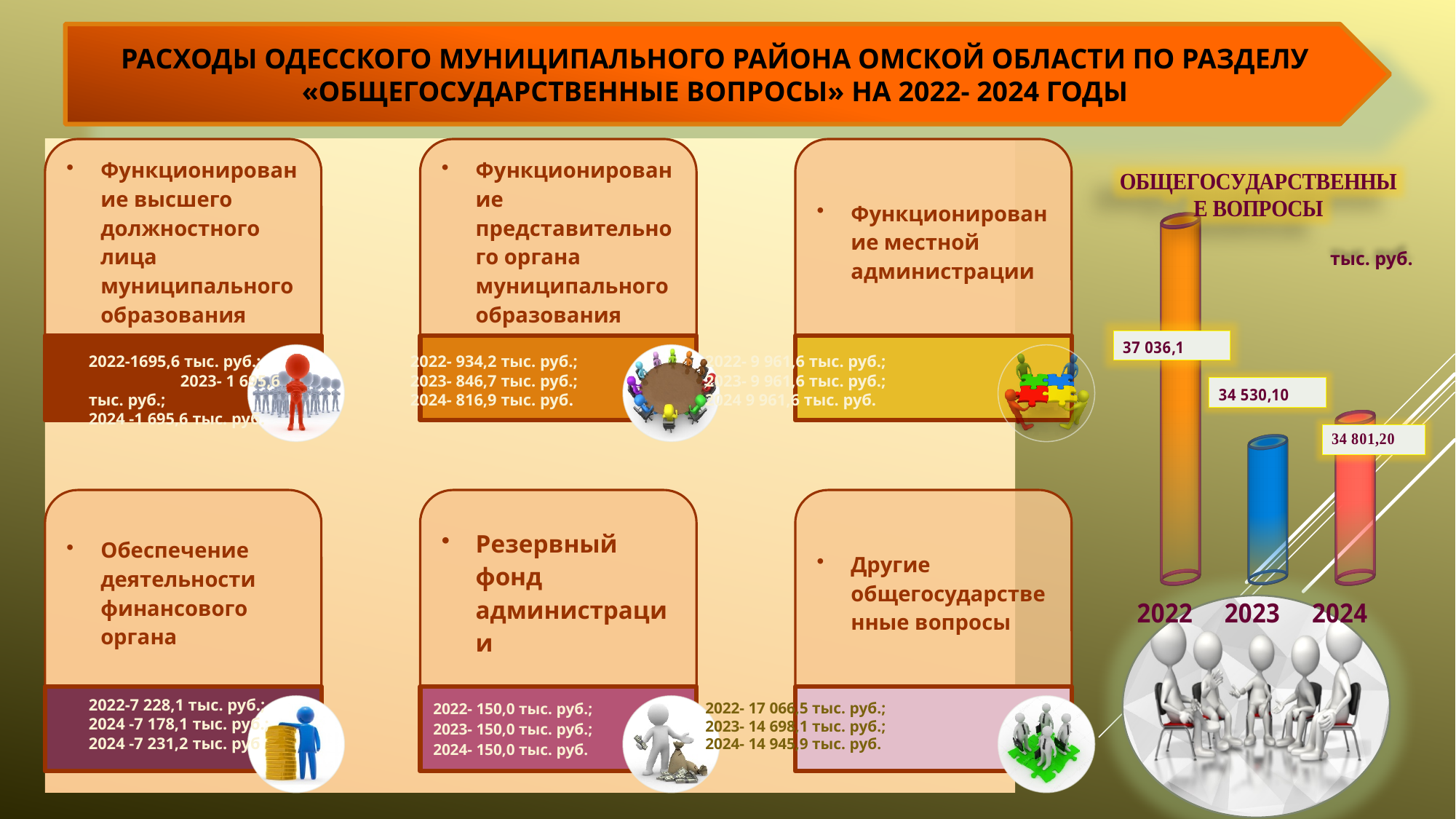
In the chart «ОБЩЕГОСУДАРСТВЕННЫЕ ВОПРОСЫ», which year has the lowest value? 2023 In the chart «ОБЩЕГОСУДАРСТВЕННЫЕ ВОПРОСЫ», how do the values change from 2022 to 2024? fall from 2022 to 2023, then rise slightly in 2024 What is the value for 2023 in the chart titled «ОБЩЕГОСУДАРСТВЕННЫЕ ВОПРОСЫ»? 34 530,10 What unit of measurement is indicated on the chart «ОБЩЕГОСУДАРСТВЕННЫЕ ВОПРОСЫ»? тыс. руб. How many years (categories) are shown in the chart «ОБЩЕГОСУДАРСТВЕННЫЕ ВОПРОСЫ»? 3 What is the value for 2022 in the chart titled «ОБЩЕГОСУДАРСТВЕННЫЕ ВОПРОСЫ»? 37 036,1 What kind of chart is the chart titled «ОБЩЕГОСУДАРСТВЕННЫЕ ВОПРОСЫ»? bar chart In the chart «ОБЩЕГОСУДАРСТВЕННЫЕ ВОПРОСЫ», what is the difference between the 2024 and 2023 values? 271,10 In the chart «ОБЩЕГОСУДАРСТВЕННЫЕ ВОПРОСЫ», what is the difference between the 2022 and 2023 values? 2 506,0 In the chart «ОБЩЕГОСУДАРСТВЕННЫЕ ВОПРОСЫ», which year has the highest value? 2022 What is the value for 2024 in the chart titled «ОБЩЕГОСУДАРСТВЕННЫЕ ВОПРОСЫ»? 34 801,20 In the chart «ОБЩЕГОСУДАРСТВЕННЫЕ ВОПРОСЫ», which is larger, the value for 2023 or for 2024? 2024